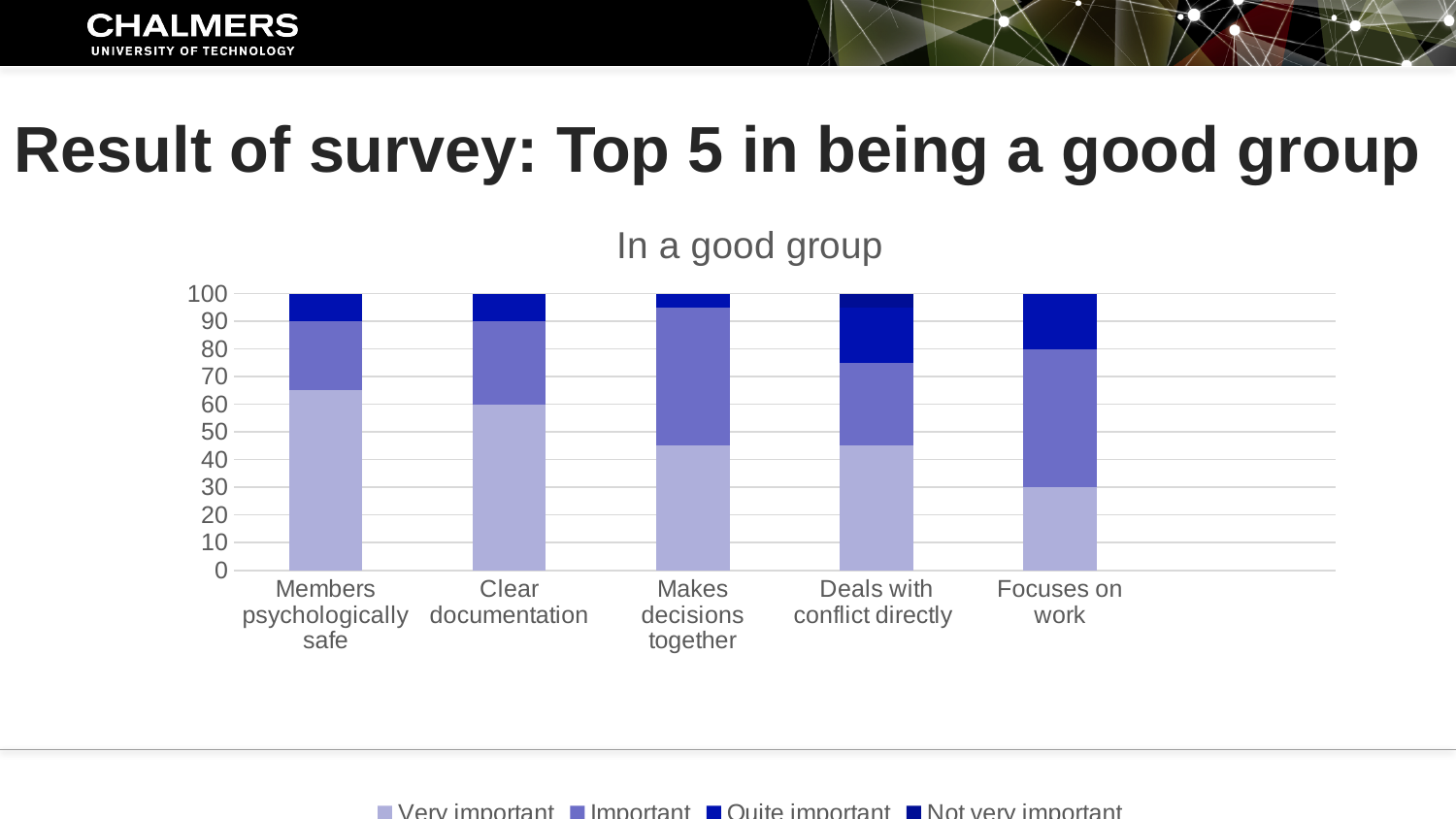
How many series does the legend list? 4 Which category has the lowest 'Very important' value? Focuses on work What is the total of the stacked bar for Members psychologically safe? 100 Which has a larger 'Very important' value: Clear documentation or Focuses on work? Clear documentation Is the 'Very important' value for Members psychologically safe greater or less than 50? greater What type of chart is shown on the slide? Stacked bar chart What is the 'Very important' value for Clear documentation? 60 Does the 'Very important' value rise or fall from left to right across the categories? Fall Is the 'Very important' value for Makes decisions together greater or less than 50? less What is the 'Very important' value for Focuses on work? 30 How many categories are shown on the x axis of the chart? 5 What is the title of the chart? In a good group